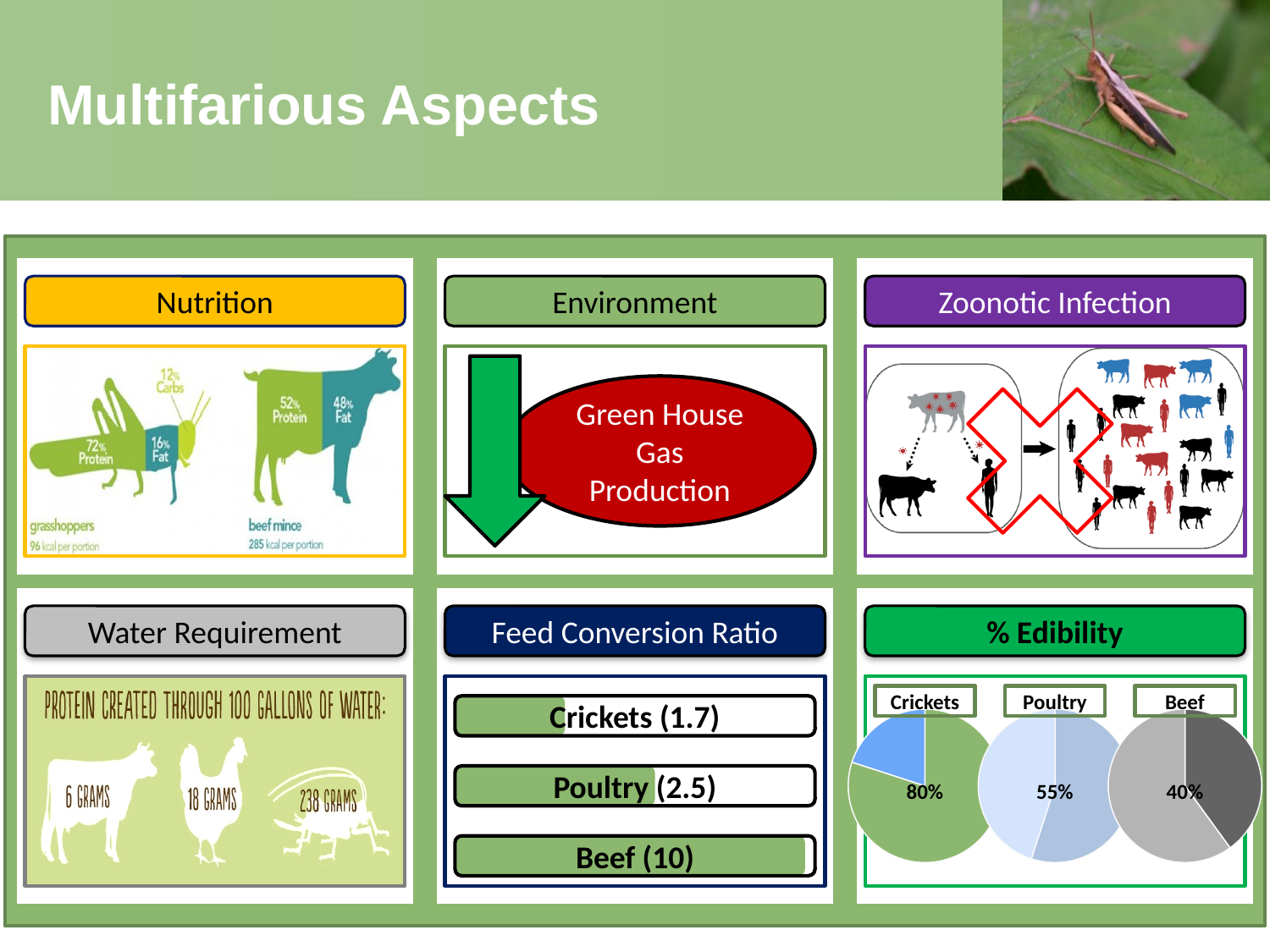
In the % Edibility charts, what percentage is shown for Poultry? 55% In the % Edibility charts, what percentage is shown for Beef? 40% In the Feed Conversion Ratio chart, which category has the highest ratio? Beef In the % Edibility charts, what is the difference between the Crickets and Beef percentages? 40% In the % Edibility charts, which category has the highest edibility percentage? Crickets In the % Edibility charts, what percentage is shown for Crickets? 80% In the % Edibility charts, which category has the lowest edibility percentage? Beef How many pie charts are shown in the % Edibility panel? 3 In the Feed Conversion Ratio chart, what is the value for Crickets? 1.7 In the Feed Conversion Ratio chart, is the value for Poultry larger or smaller than the value for Crickets? Larger In the % Edibility charts, what kind of chart is used to show each category? Pie chart In the Feed Conversion Ratio chart, what is the value for Beef? 10